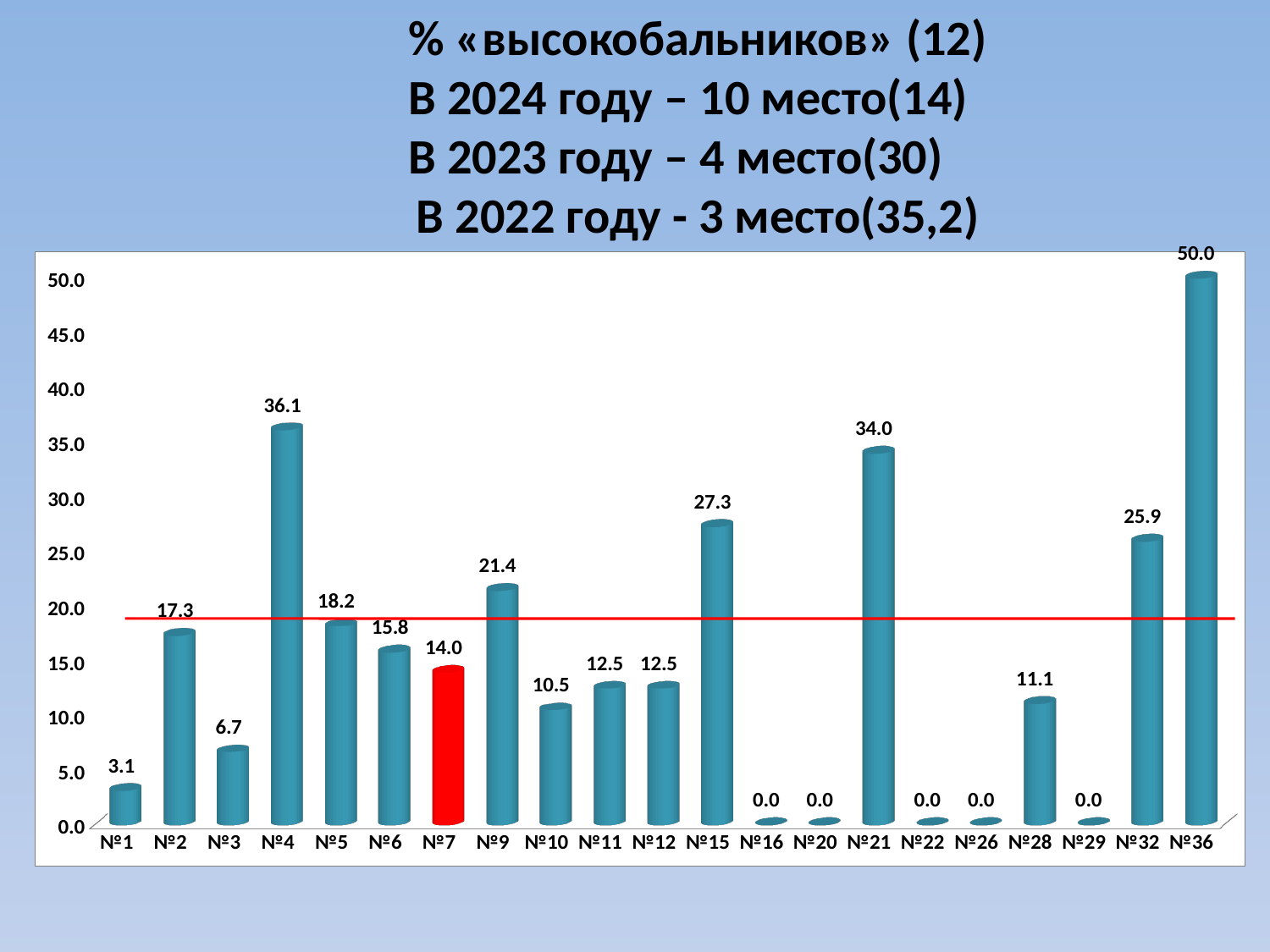
What is the value for №4? 36.1 What is the difference between the values for №4 and №7? 22.1 Which is larger, the value for №15 or the value for №32? №15 Which is larger, the value for №2 or the value for №5? №5 What kind of chart is shown on the slide? Bar chart What is the value for №21? 34.0 What is the value for №7, the red bar? 14.0 How many categories have a value of 0.0? 5 What is the difference between the values for №36 and №21? 16.0 Which category has the highest value? №36 Which category's bar is coloured red? №7 How many categories are shown on the x axis? 21